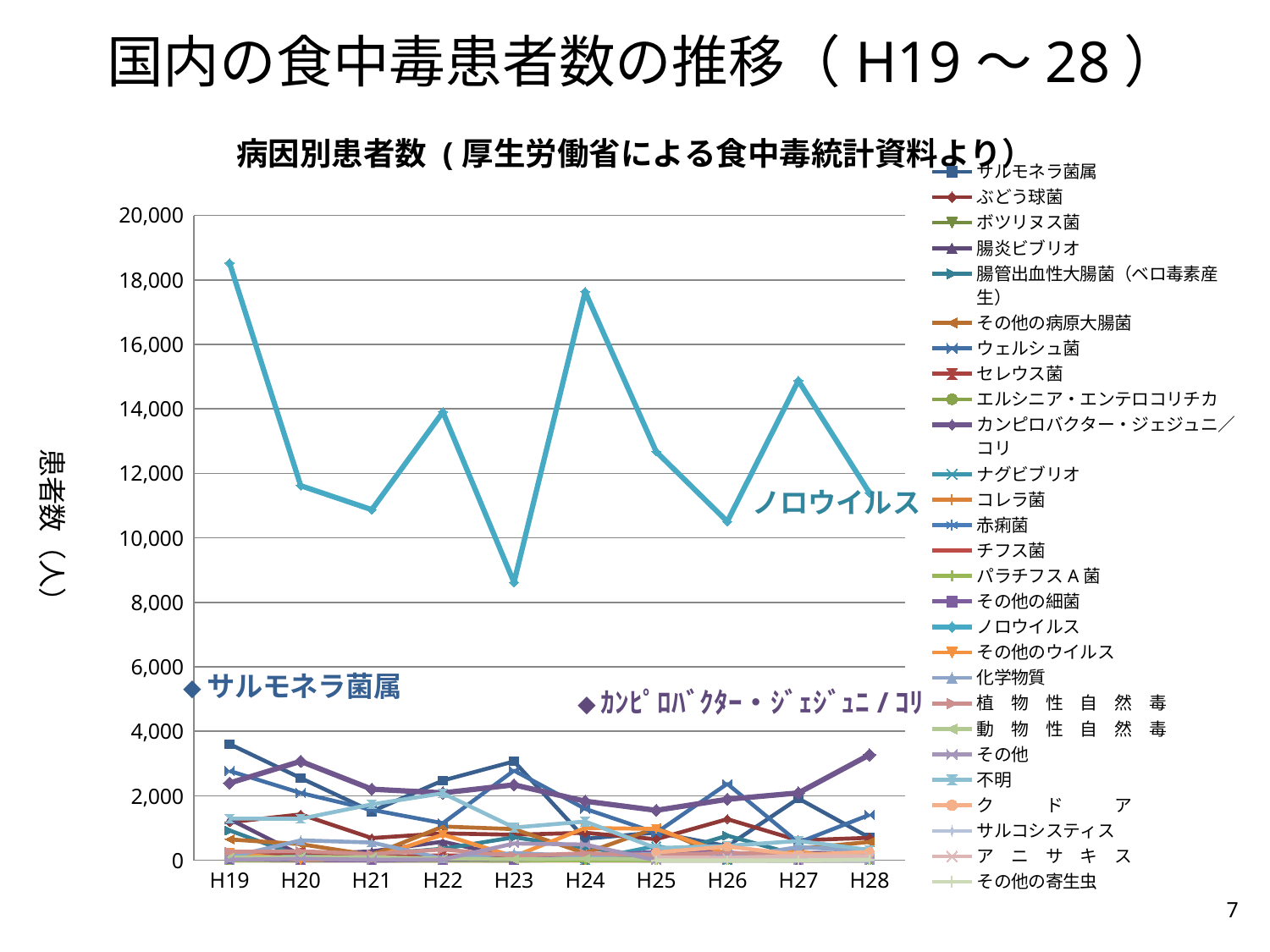
What is the title of the chart? 病因別患者数（厚生労働省による食中毒統計資料より） Which is larger for ノロウイルス: the value in H19 or the value in H24? H19 Does the value for ノロウイルス rise or fall from H19 to H20? fall In which year is the value for ノロウイルス highest? H19 Is the value for ノロウイルス in H24 greater or less than 16,000? greater What kind of chart is shown on the slide? line chart How many series does the legend list? 27 How many years (points) are shown along the x axis? 10 Is the value for ノロウイルス in H23 greater or less than 10,000? less Which series has the highest values in the chart? ノロウイルス Is the value for ノロウイルス in H19 greater or less than 18,000? greater In which year is the value for ノロウイルス lowest? H23